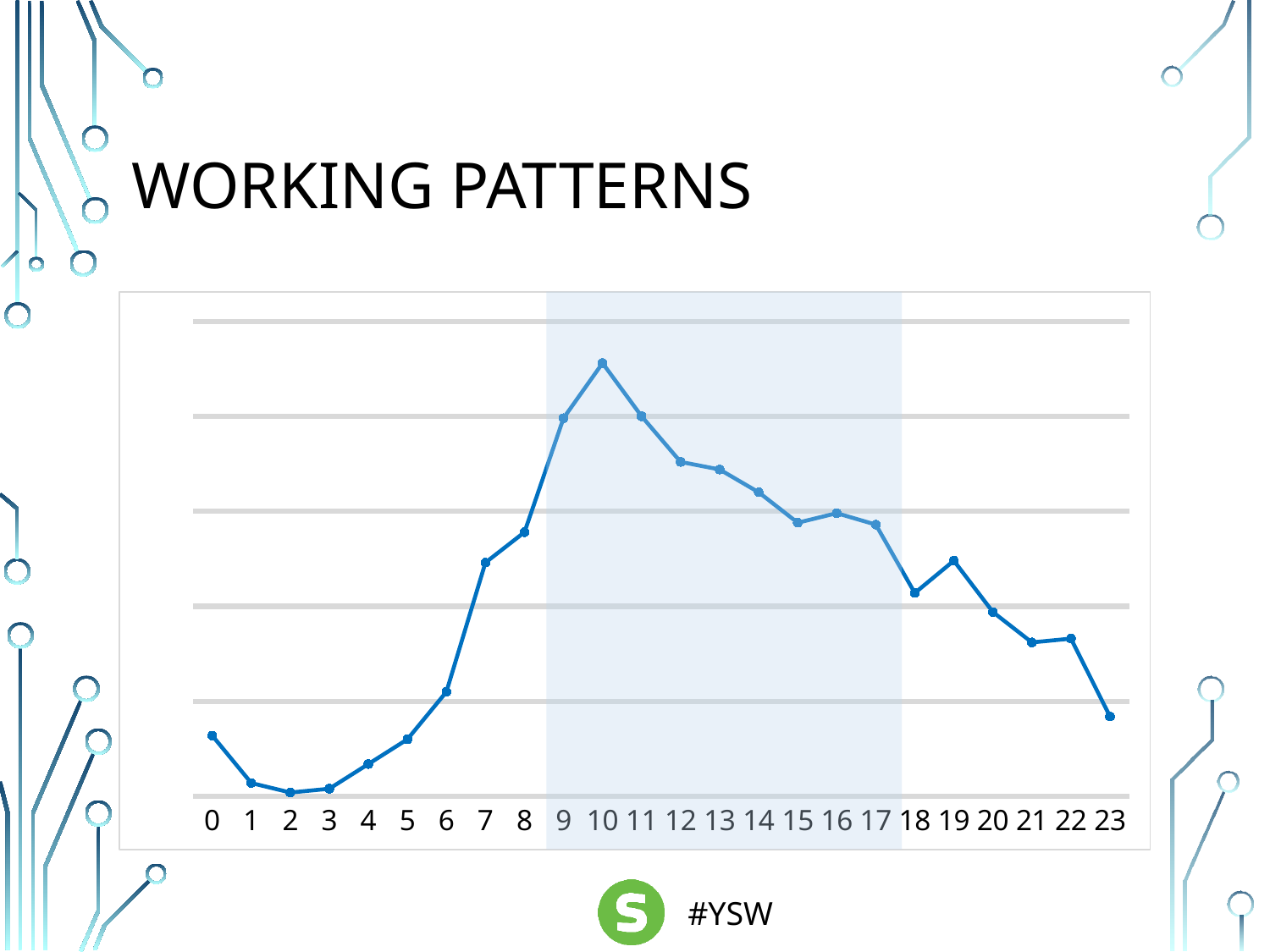
Does the line rise or fall between hours 10 and 18? fall Which range of hours on the x axis is highlighted with a shaded background? 9 to 17 Which hour has the higher value, 0 or 23? 23 Which hour has the higher value, 9 or 17? 9 Which hour has the higher value, 18 or 19? 19 Does the line rise or fall between hours 2 and 10? rise What is the title of the slide containing the chart? WORKING PATTERNS How many data points are plotted on the line? 24 At which hour on the x axis does the line reach its highest value? 10 What kind of chart is shown on the slide? line chart How many lines are plotted on the chart? 1